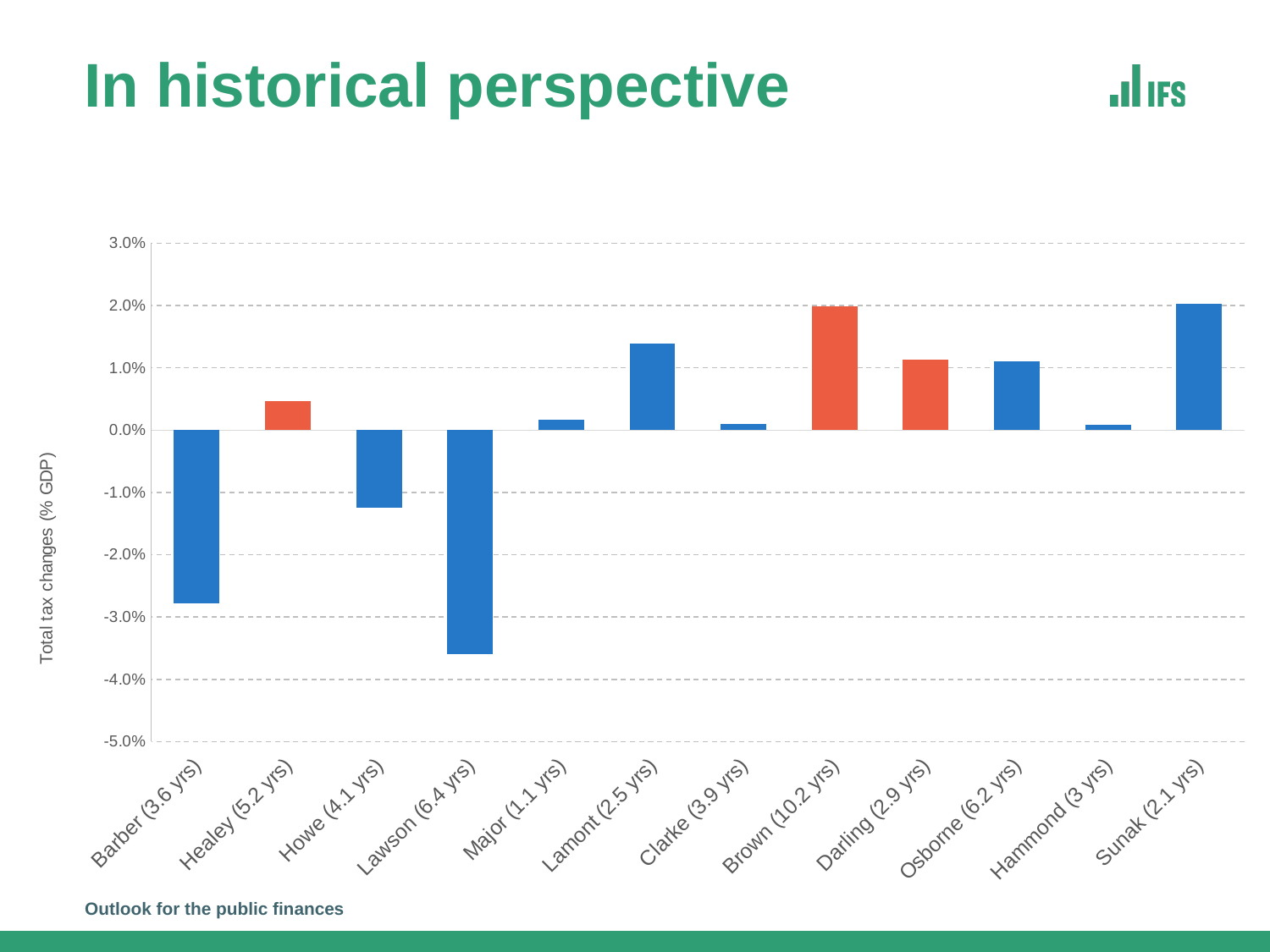
What kind of chart is shown on the slide? bar chart Which is lower, the value for Barber (3.6 yrs) or the value for Howe (4.1 yrs)? Barber (3.6 yrs) Is the value for Barber (3.6 yrs) greater or less than -2.0%? less Is the value for Healey (5.2 yrs) greater or less than 1.0%? less Which chancellor has the lowest value for total tax changes? Lawson (6.4 yrs) Is the value for Lamont (2.5 yrs) greater or less than 1.0%? greater Which is larger, the value for Lamont (2.5 yrs) or the value for Darling (2.9 yrs)? Lamont (2.5 yrs) What is the label on the vertical axis? Total tax changes (% GDP) How many bars are coloured red/orange rather than blue? 3 How many chancellors (categories) are shown on the x axis? 12